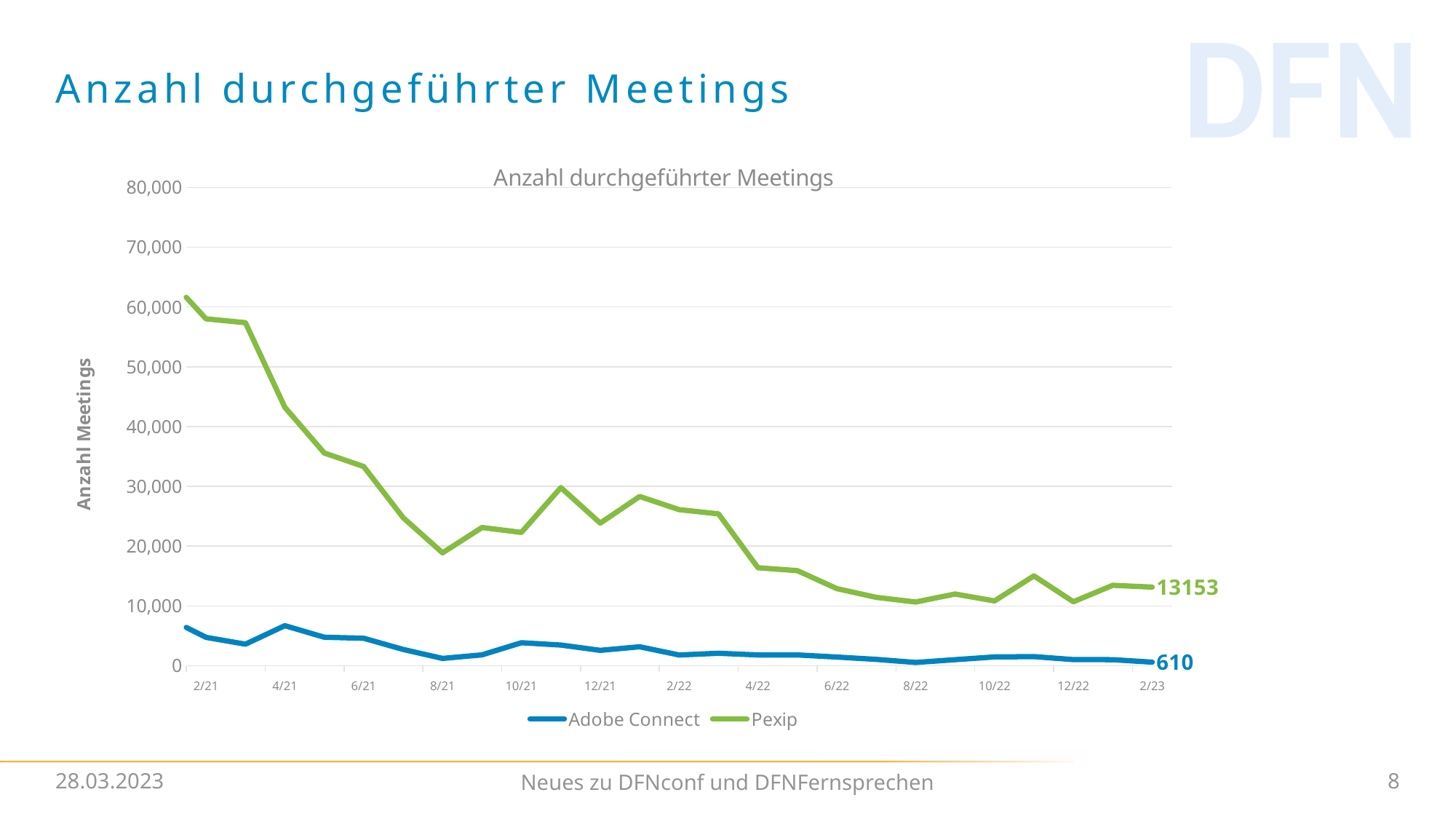
What is the difference between the Pexip and Adobe Connect values at 2/23? 12543 How many series does the legend list? 2 At 2/23, which series has the larger value, Pexip or Adobe Connect? Pexip What is the value for Pexip at 2/23? 13153 What is the value for Adobe Connect at 2/23? 610 What kind of chart is shown on the slide? Line chart Is the value for Pexip at 2/21 greater or less than 50,000? greater Is the value for Adobe Connect at 2/21 greater or less than 10,000? less What is the title of the chart? Anzahl durchgeführter Meetings Does the Pexip line generally rise or fall from 2/21 to 2/23? Fall What is the title of the y axis? Anzahl Meetings Is the value for Pexip at 6/22 greater or less than 20,000? less